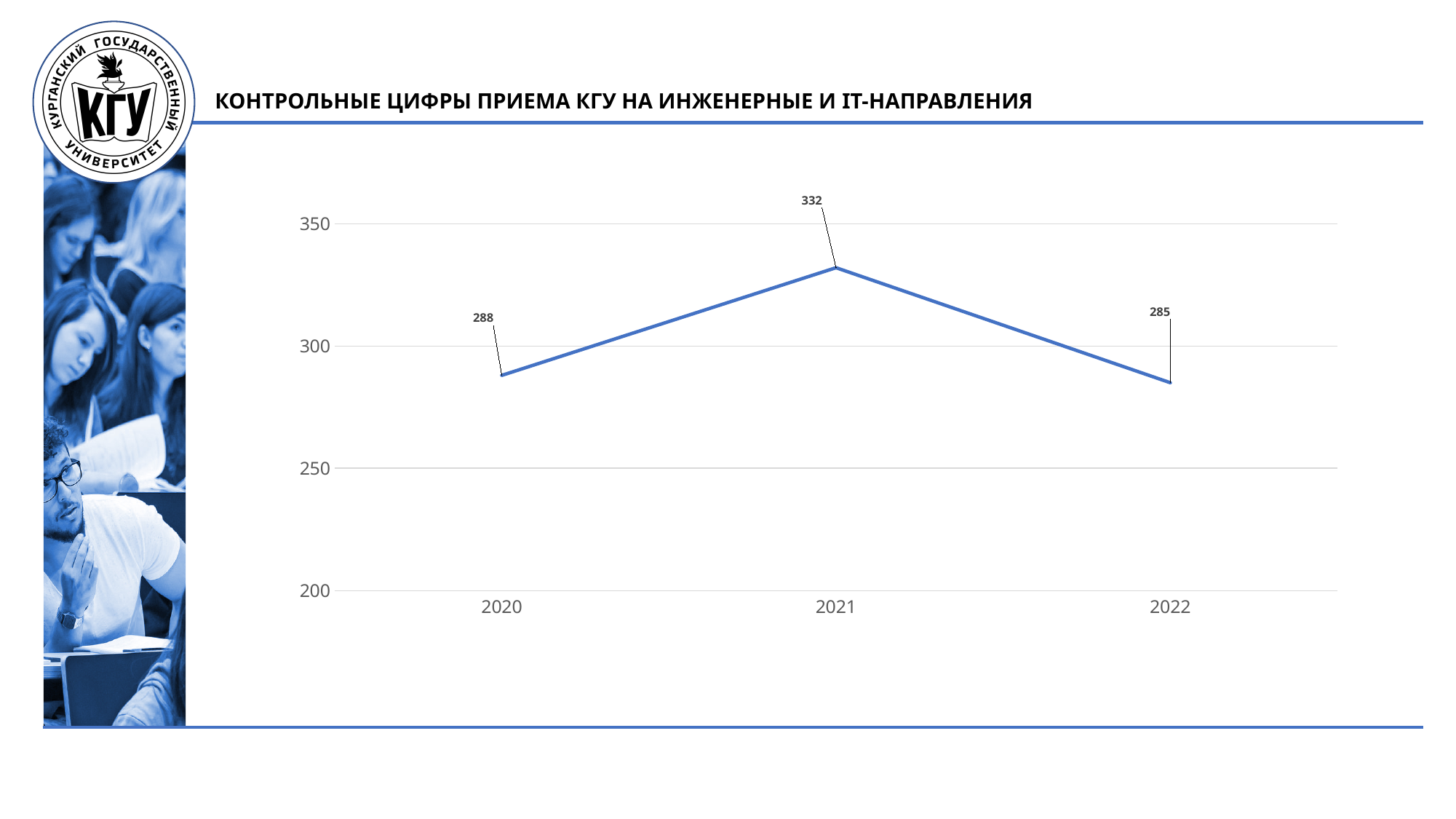
What is the value for 2020? 288 What is the difference between the values for 2021 and 2020? 44 Does the value rise or fall from 2021 to 2022? fall What kind of chart is shown on the slide? line chart How many years are plotted on the chart? 3 Which year has the lowest value? 2022 Which year has the highest value? 2021 What is the value for 2021? 332 Is the value for 2021 greater or less than 300? greater What is the difference between the values for 2021 and 2022? 47 What is the value for 2022? 285 Which is larger, the value for 2020 or the value for 2022? 2020